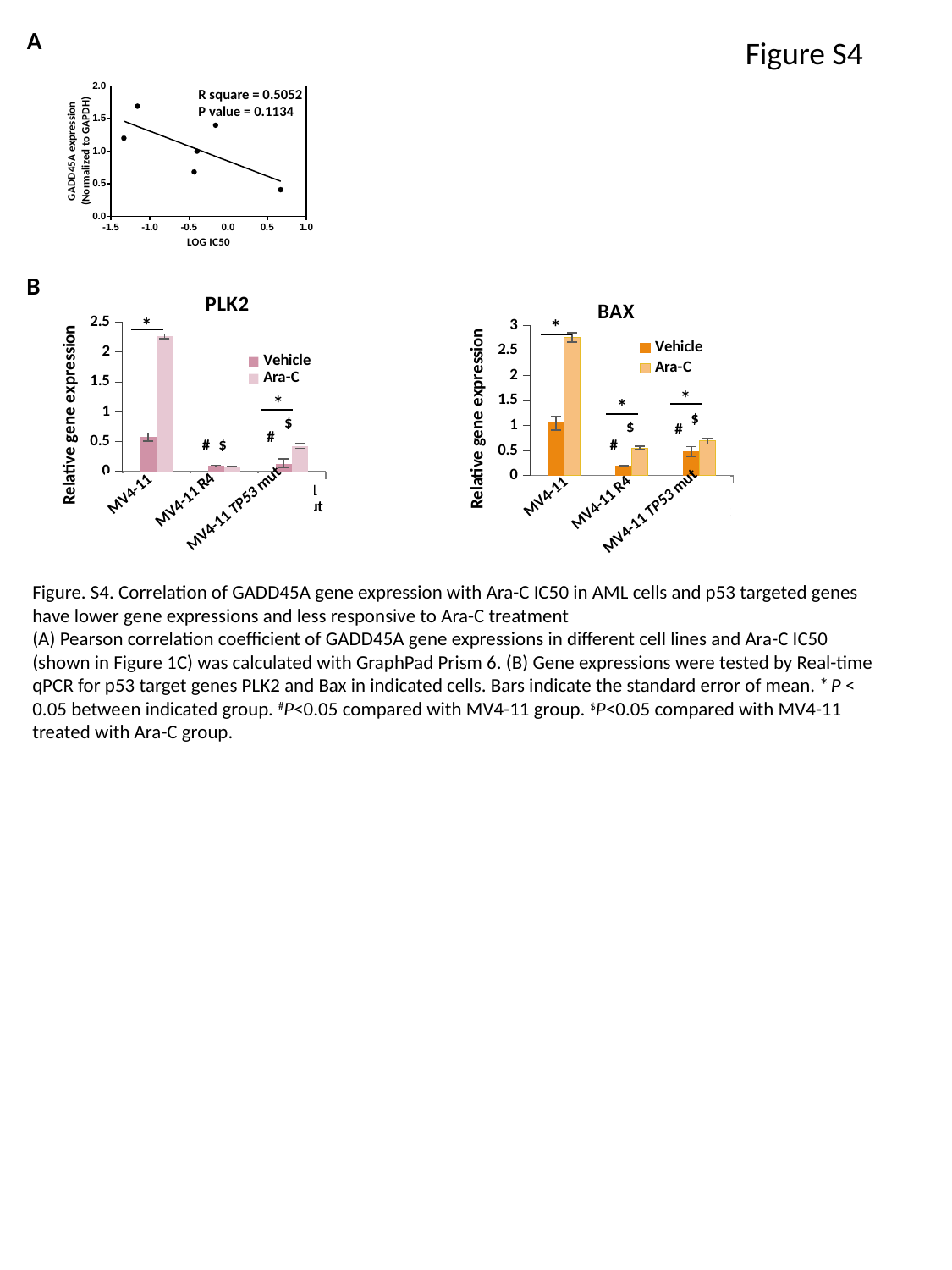
In the PLK2 chart, is the Ara-C value for MV4-11 greater or less than 2? greater In the panel A scatter chart, does the fitted line rise or fall as LOG IC50 increases? fall What are the two legend entries on the BAX chart? Vehicle and Ara-C What kind of chart is the chart in panel A (GADD45A expression vs LOG IC50)? scatter chart In the BAX chart, which is larger for MV4-11 R4, the Vehicle value or the Ara-C value? Ara-C In the BAX chart, is the Vehicle value for MV4-11 greater or less than 0.5? greater In the BAX chart, which category has the lowest Vehicle value? MV4-11 R4 What kind of chart is the PLK2 chart? bar chart In the BAX chart, is the Ara-C value for MV4-11 greater or less than 2.5? greater In the PLK2 chart, which category has the highest Ara-C value? MV4-11 How many series does the legend of the PLK2 chart list? 2 How many cell line categories are shown on the x axis of the BAX chart? 3